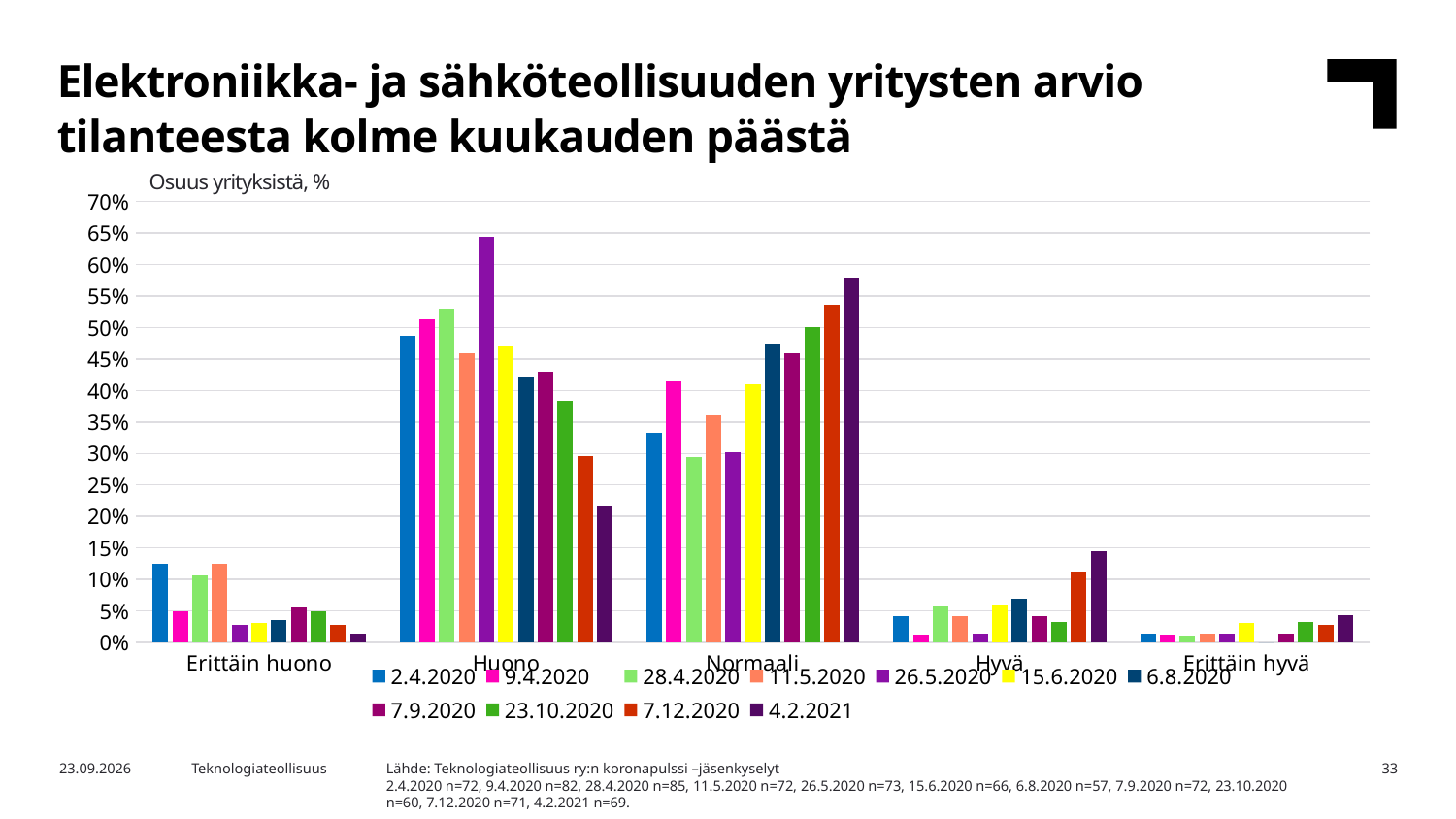
How many series does the legend list? 11 Which series has the highest value in the Huono category? 26.5.2020 For the 2.4.2020 series, which is larger: the value for Huono or the value for Normaali? Huono Which series has the highest value in the Normaali category? 4.2.2021 Which category contains the tallest bar in the chart? Huono Is the value for 26.5.2020 in the Huono category greater or less than 60%? greater What kind of chart is shown on the slide? bar chart For the 4.2.2021 series, which is larger: the value for Normaali or the value for Huono? Normaali Is the value for 2.4.2020 in the Erittäin huono category greater or less than 10%? greater How many categories are shown on the x axis? 5 What is the label shown on the vertical axis of the chart? Osuus yrityksistä, % Is the value for 4.2.2021 in the Huono category greater or less than 25%? less